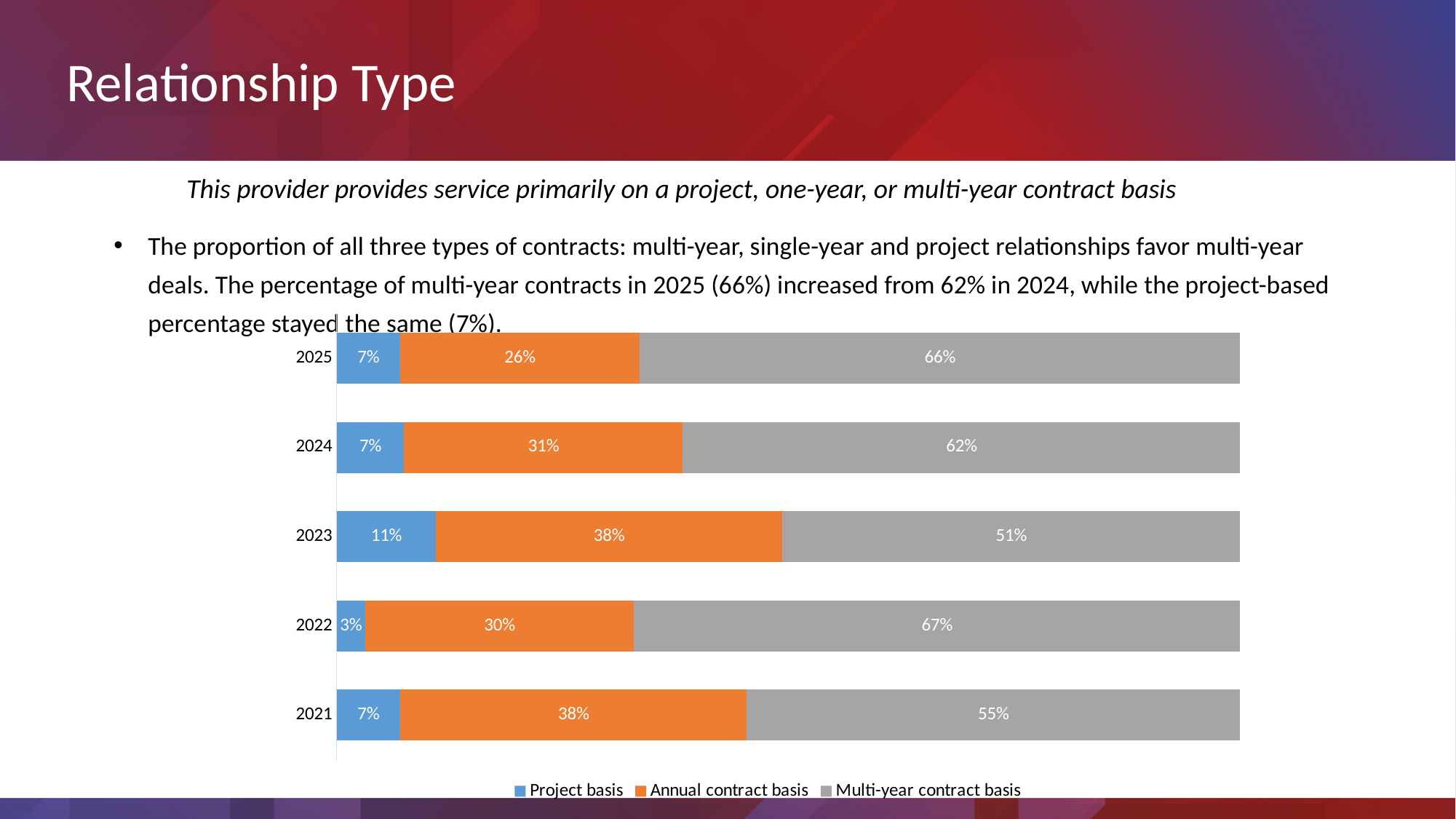
How many years are shown on the chart? 5 What is the Annual contract basis value for 2023? 38% What is the difference between the Multi-year contract basis values for 2025 and 2024? 4% What is the total of the stacked bar for 2021? 100% Which year has the lowest Project basis value? 2022 What kind of chart is shown on the slide? Stacked bar chart What is the Multi-year contract basis value for 2025? 66% Which colour represents Annual contract basis in the legend? Orange What is the Project basis value for 2022? 3% Which is larger, the Annual contract basis value for 2024 or for 2022? 2024 How many series does the legend list? 3 Which year has the highest Multi-year contract basis value? 2022